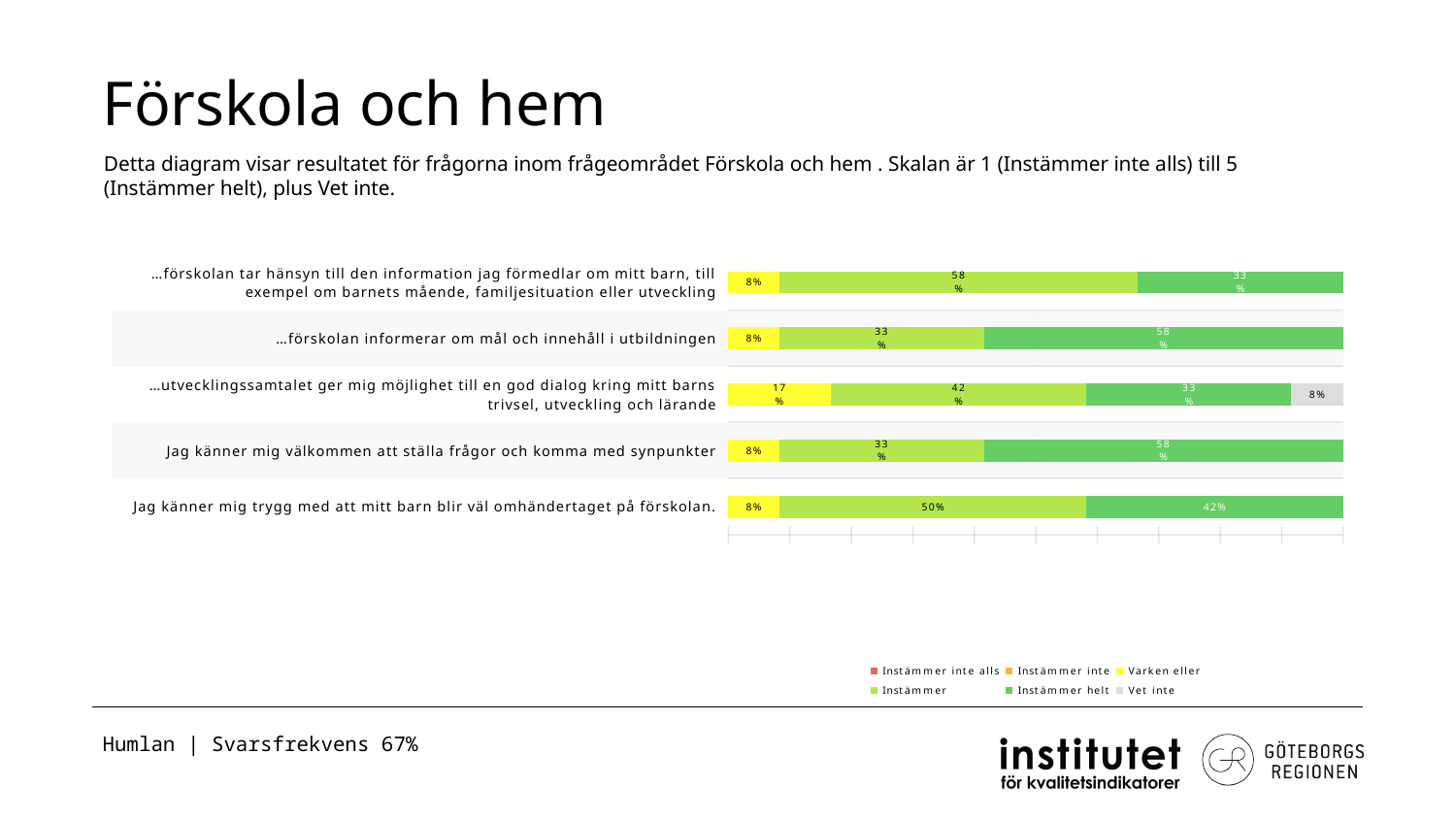
How many questions (categories) are plotted in the chart? 5 What kind of chart is shown on the slide? Stacked bar chart How many series does the legend list? 6 What is the 'Instämmer' value for '…förskolan tar hänsyn till den information jag förmedlar om mitt barn, till exempel om barnets mående, familjesituation eller utveckling'? 58% What is the 'Vet inte' value for '…utvecklingssamtalet ger mig möjlighet till en god dialog kring mitt barns trivsel, utveckling och lärande'? 8% Which is larger for 'Jag känner mig välkommen att ställa frågor och komma med synpunkter': the 'Instämmer' value or the 'Instämmer helt' value? Instämmer helt What is the difference between the 'Instämmer helt' value for '…förskolan informerar om mål och innehåll i utbildningen' and for 'Jag känner mig trygg med att mitt barn blir väl omhändertaget på förskolan'? 16 percentage points What is the 'Varken eller' value for '…utvecklingssamtalet ger mig möjlighet till en god dialog kring mitt barns trivsel, utveckling och lärande'? 17% What is the 'Instämmer helt' value for 'Jag känner mig trygg med att mitt barn blir väl omhändertaget på förskolan'? 42% Which colour represents 'Vet inte' in the chart? Grey Which question has the highest 'Instämmer' share? …förskolan tar hänsyn till den information jag förmedlar om mitt barn, till exempel om barnets mående, familjesituation eller utveckling Which question has the highest 'Varken eller' share? …utvecklingssamtalet ger mig möjlighet till en god dialog kring mitt barns trivsel, utveckling och lärande